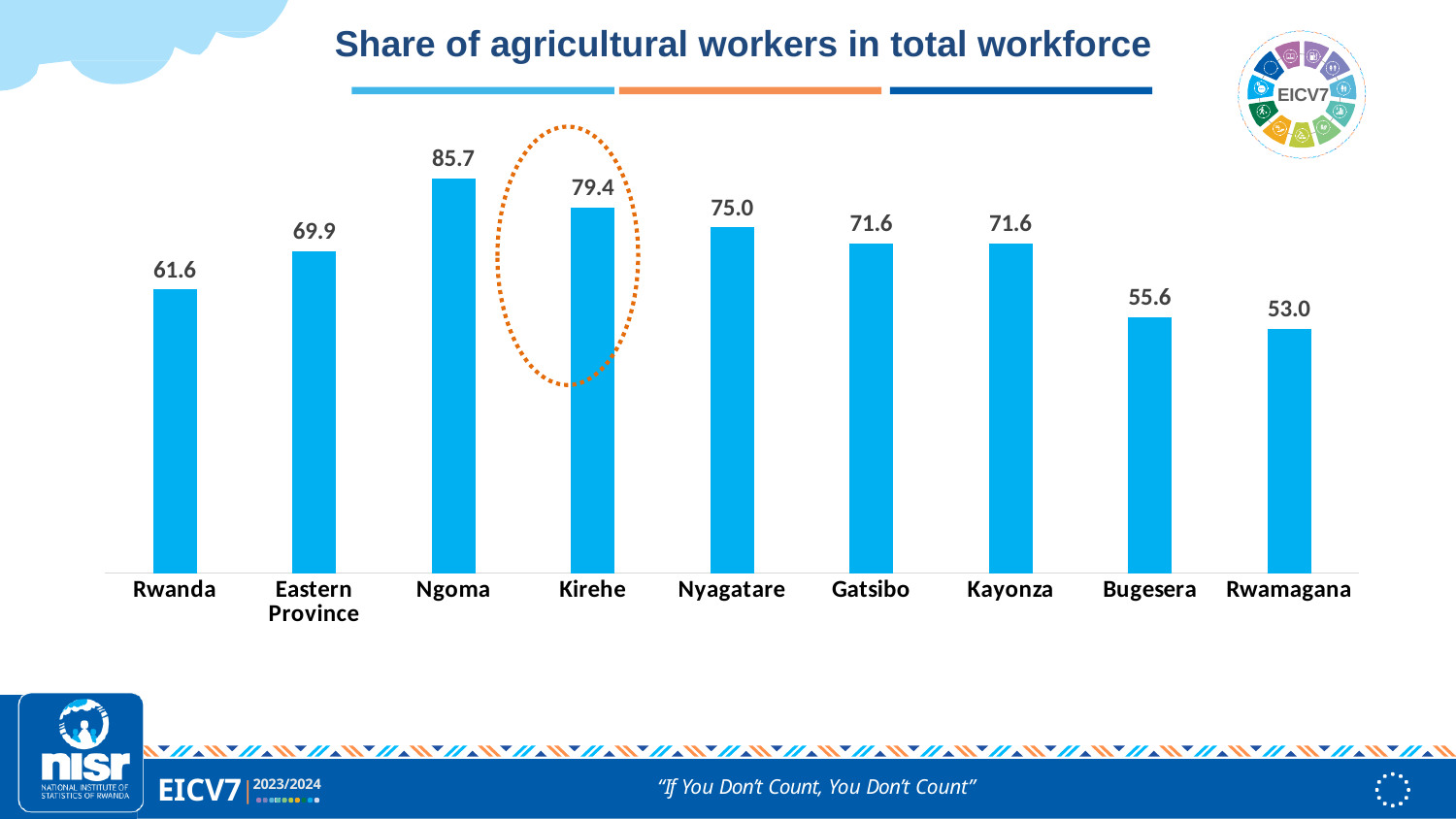
What is the share of agricultural workers in the total workforce for Kirehe? 79.4 What is the difference between the values for Ngoma and Rwamagana? 32.7 What kind of chart is shown on the slide? Bar chart What is the difference between the values for Kirehe and Eastern Province? 9.5 What value is shown for Eastern Province? 69.9 How many categories are shown on the x axis? 9 Which category has the highest share of agricultural workers? Ngoma Which category has the lowest share of agricultural workers? Rwamagana Which bar is highlighted with a dotted orange circle? Kirehe Which has a larger value, Rwanda or Gatsibo? Gatsibo What value is shown for Rwanda? 61.6 Which has a larger value, Nyagatare or Bugesera? Nyagatare